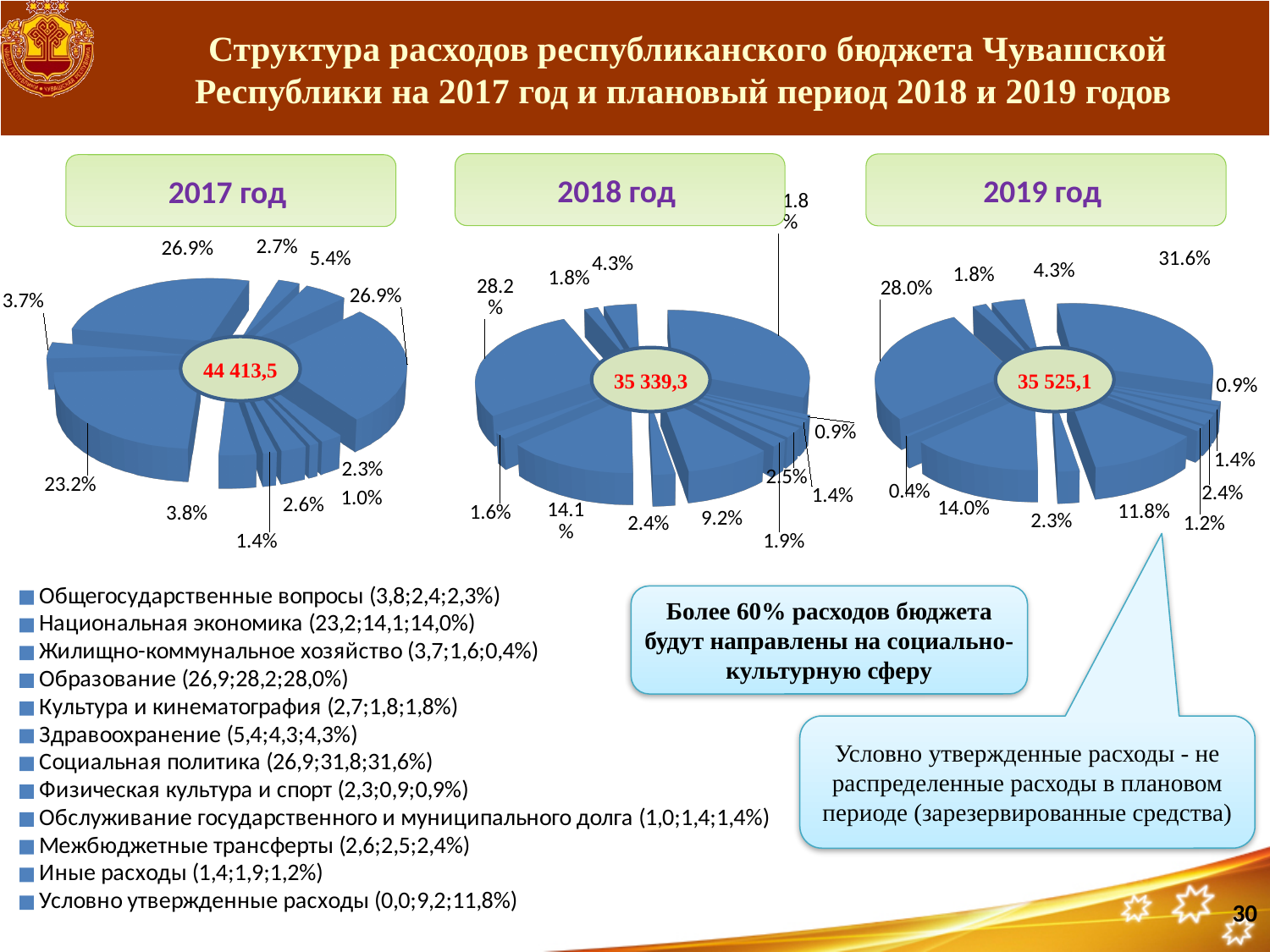
What kind of charts are shown on the slide? Pie charts In the 2017 год chart, what share is Культура и кинематография? 2.7% In the 2019 год chart, which category has the largest share? Социальная политика (31.6%) In the 2018 год chart, what is the difference between the shares of Образование and Национальная экономика? 14.1 percentage points How many pie charts are on the slide? 3 In the 2017 год chart, which is larger: Здравоохранение or Общегосударственные вопросы? Здравоохранение Does the share of Национальная экономика rise or fall from 2017 to 2019? Falls In the 2018 год chart, what share is Социальная политика? 31.8% In the 2019 год chart, what share is Условно утвержденные расходы? 11.8% What total value is printed in the centre of the 2017 год pie chart? 44 413,5 In the 2019 год chart, which category has the smallest share? Жилищно-коммунальное хозяйство (0.4%) How many expenditure categories does the legend list? 12